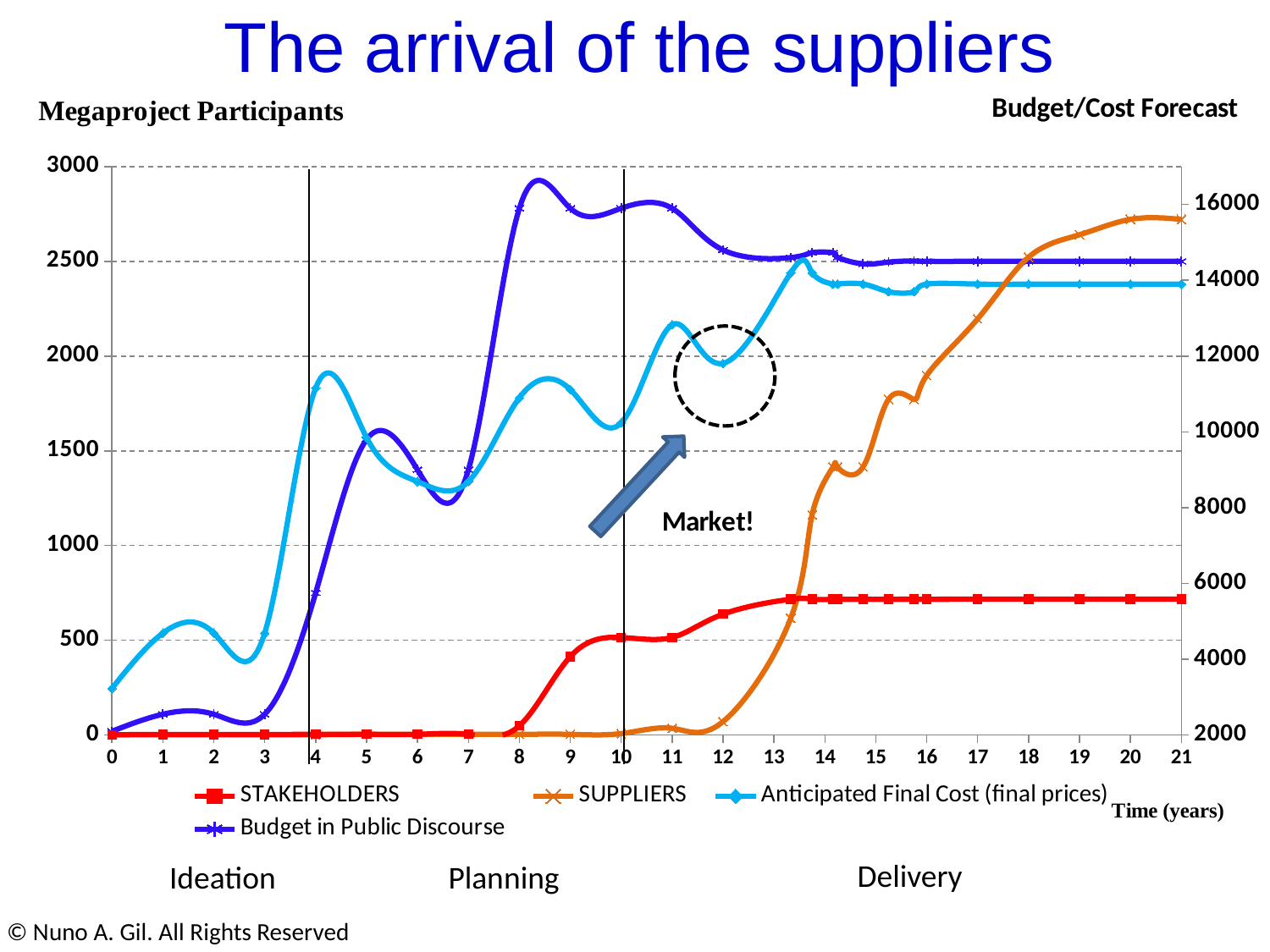
Is the value for Budget in Public Discourse at year 8 greater or less than 14000? greater What kind of chart is shown on the slide? line chart At year 20, which is higher: SUPPLIERS or STAKEHOLDERS? SUPPLIERS At year 12, which is higher: Budget in Public Discourse or Anticipated Final Cost (final prices)? Budget in Public Discourse What is the label of the left vertical axis? Megaproject Participants Is the value for SUPPLIERS at year 20 greater or less than 2500? greater Is the value for STAKEHOLDERS at year 20 greater or less than 500? greater How many series does the legend list? 4 Do the values for SUPPLIERS rise or fall from year 10 to year 20? rise